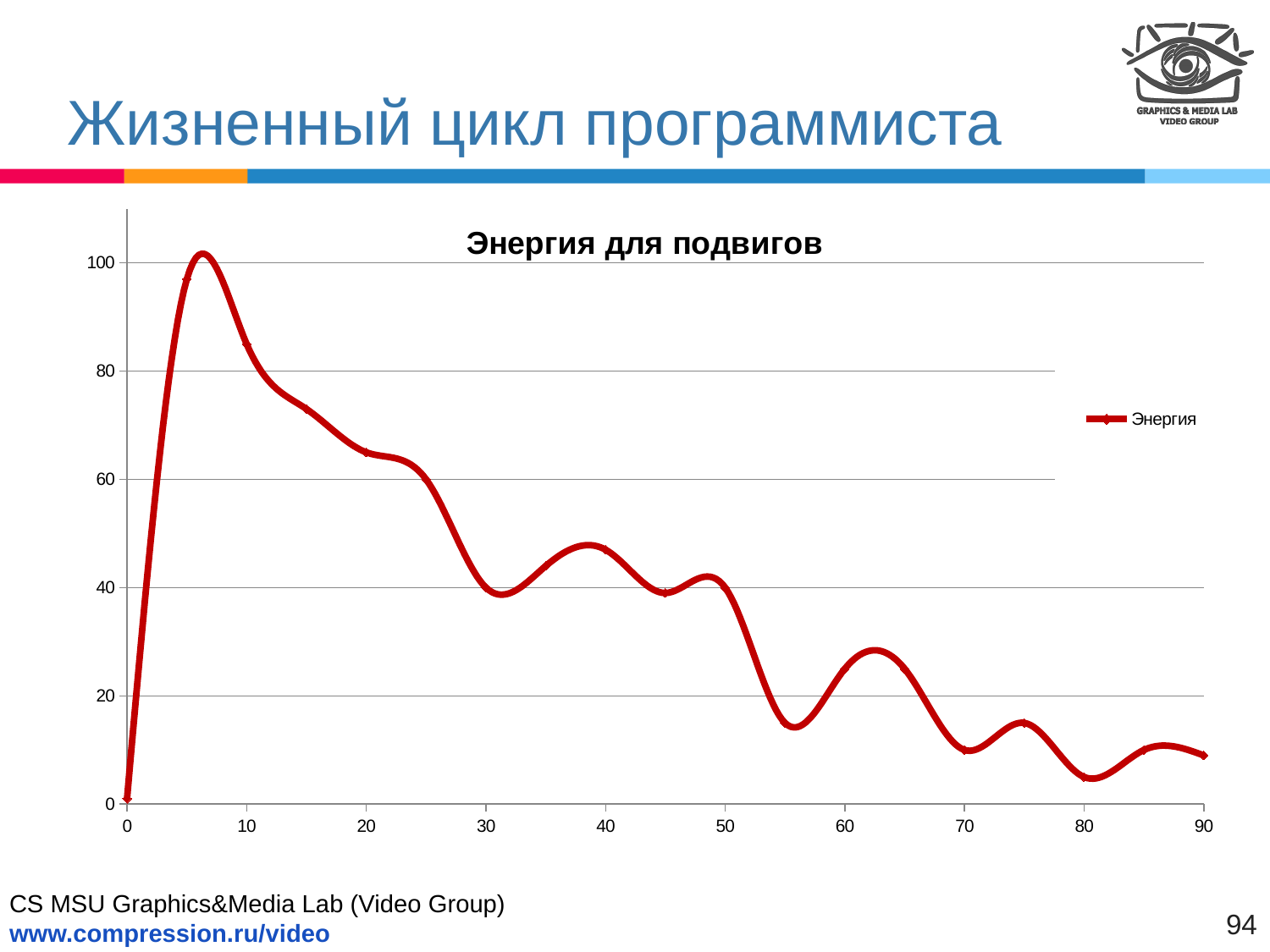
Is the value of Энергия at x = 60 greater or less than 20? greater Is the value of Энергия at x = 20 greater or less than 60? greater What is the name of the series shown in the legend? Энергия Is the value of Энергия at x = 90 greater or less than 20? less How many series does the legend list? 1 Does the value of Энергия generally rise or fall along the x axis from x = 10 to x = 90? fall What is the title of the chart? Энергия для подвигов Which is larger, the value of Энергия at x = 10 or at x = 60? x = 10 What kind of chart is shown on the slide? line chart